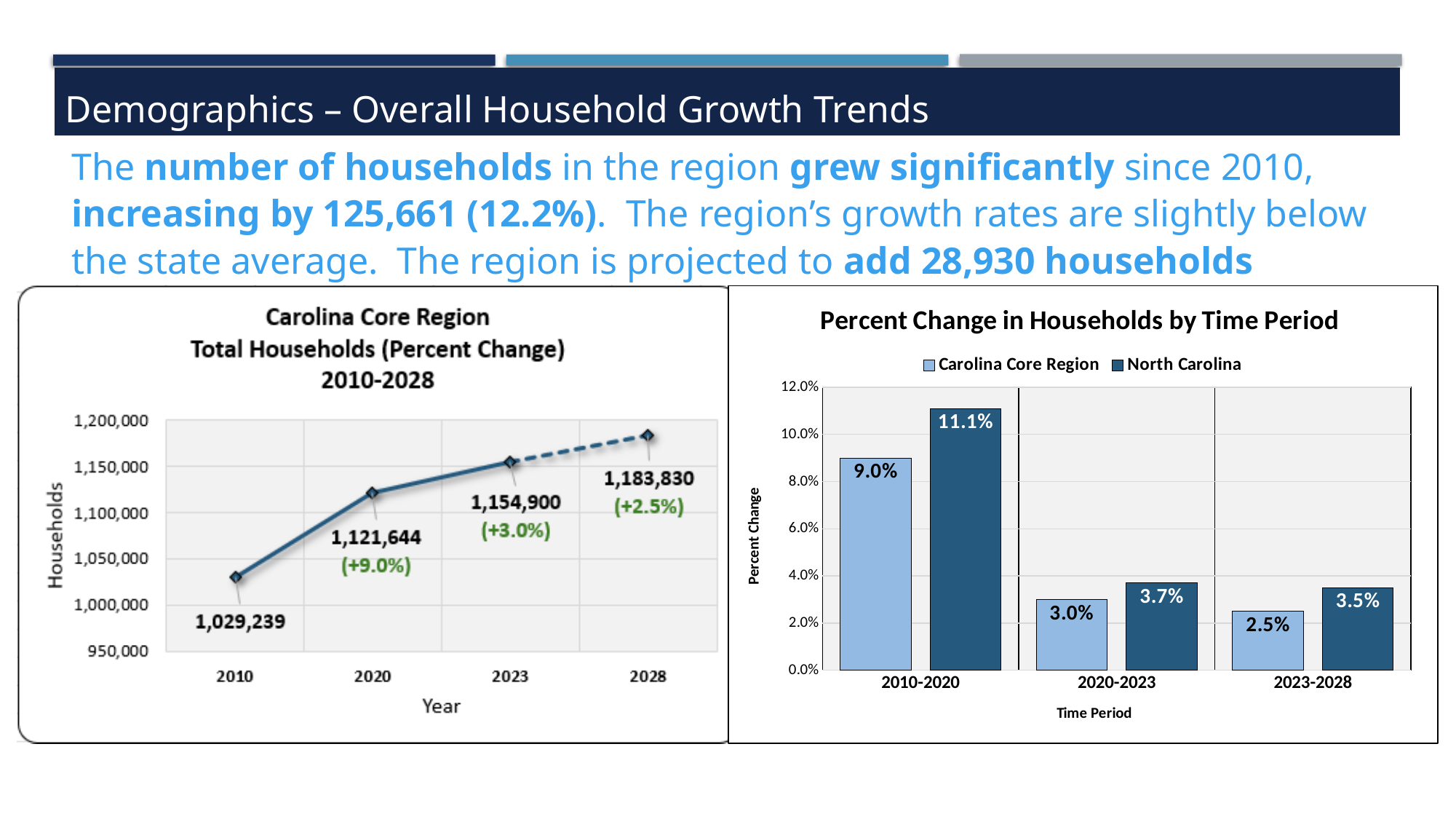
In the 'Carolina Core Region Total Households (Percent Change) 2010-2028' chart, what is the number of households in 2010? 1,029,239 In the 'Carolina Core Region Total Households (Percent Change) 2010-2028' chart, how many years are plotted? 4 In the 'Percent Change in Households by Time Period' chart, which time period has the highest value for Carolina Core Region? 2010-2020 In the 'Carolina Core Region Total Households (Percent Change) 2010-2028' chart, what is the number of households in 2020? 1,121,644 In the 'Carolina Core Region Total Households (Percent Change) 2010-2028' chart, do households rise or fall from 2010 to 2028? rise How many series does the legend of the 'Percent Change in Households by Time Period' chart list? 2 In the 'Percent Change in Households by Time Period' chart, what is the difference between North Carolina and Carolina Core Region in 2010-2020? 2.1% In the 'Carolina Core Region Total Households (Percent Change) 2010-2028' chart, what is the projected number of households in 2028? 1,183,830 In the 'Percent Change in Households by Time Period' chart, what is the value for Carolina Core Region in 2023-2028? 2.5% In the 'Carolina Core Region Total Households (Percent Change) 2010-2028' chart, what is the difference in households between 2023 and 2020? 33,256 What kind of chart is the 'Carolina Core Region Total Households (Percent Change) 2010-2028' chart? line chart In the 'Percent Change in Households by Time Period' chart, what is the value for North Carolina in 2010-2020? 11.1%